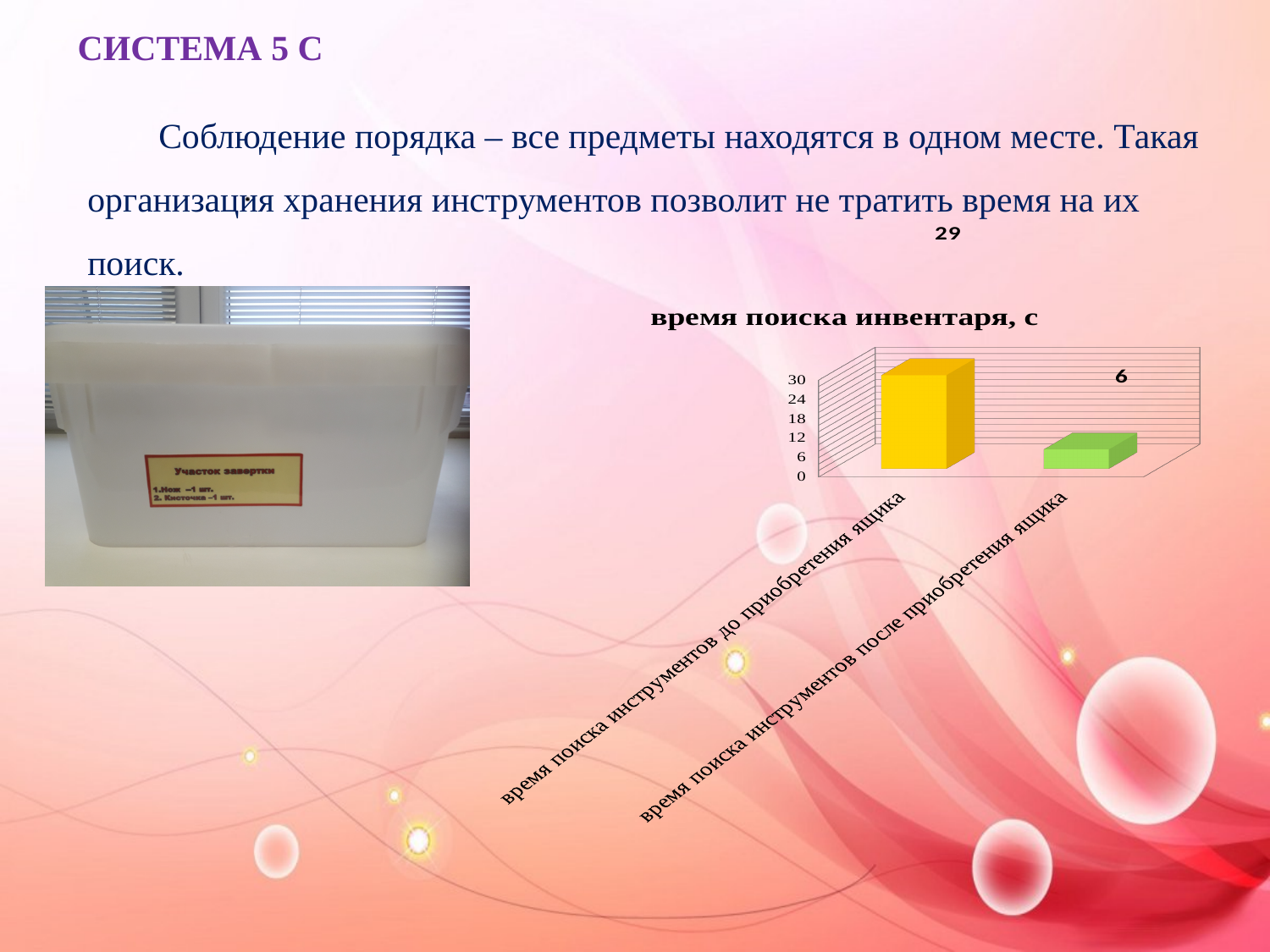
What type of chart is shown on the slide? bar chart What is the difference between the search time before and after acquiring the box? 23 What is the value for "время поиска инструментов до приобретения ящика"? 29 What is the title of the chart? время поиска инвентаря, с Which category has the lowest value? время поиска инструментов после приобретения ящика How many categories does the chart show? 2 What colour is the bar for "время поиска инструментов после приобретения ящика"? green What is the value for "время поиска инструментов после приобретения ящика"? 6 Which is larger: the search time before acquiring the box or after acquiring the box? время поиска инструментов до приобретения ящика Which category has the highest value? время поиска инструментов до приобретения ящика Is the value for "время поиска инструментов до приобретения ящика" greater or less than 24? greater Do the values rise or fall from the first category to the second? fall